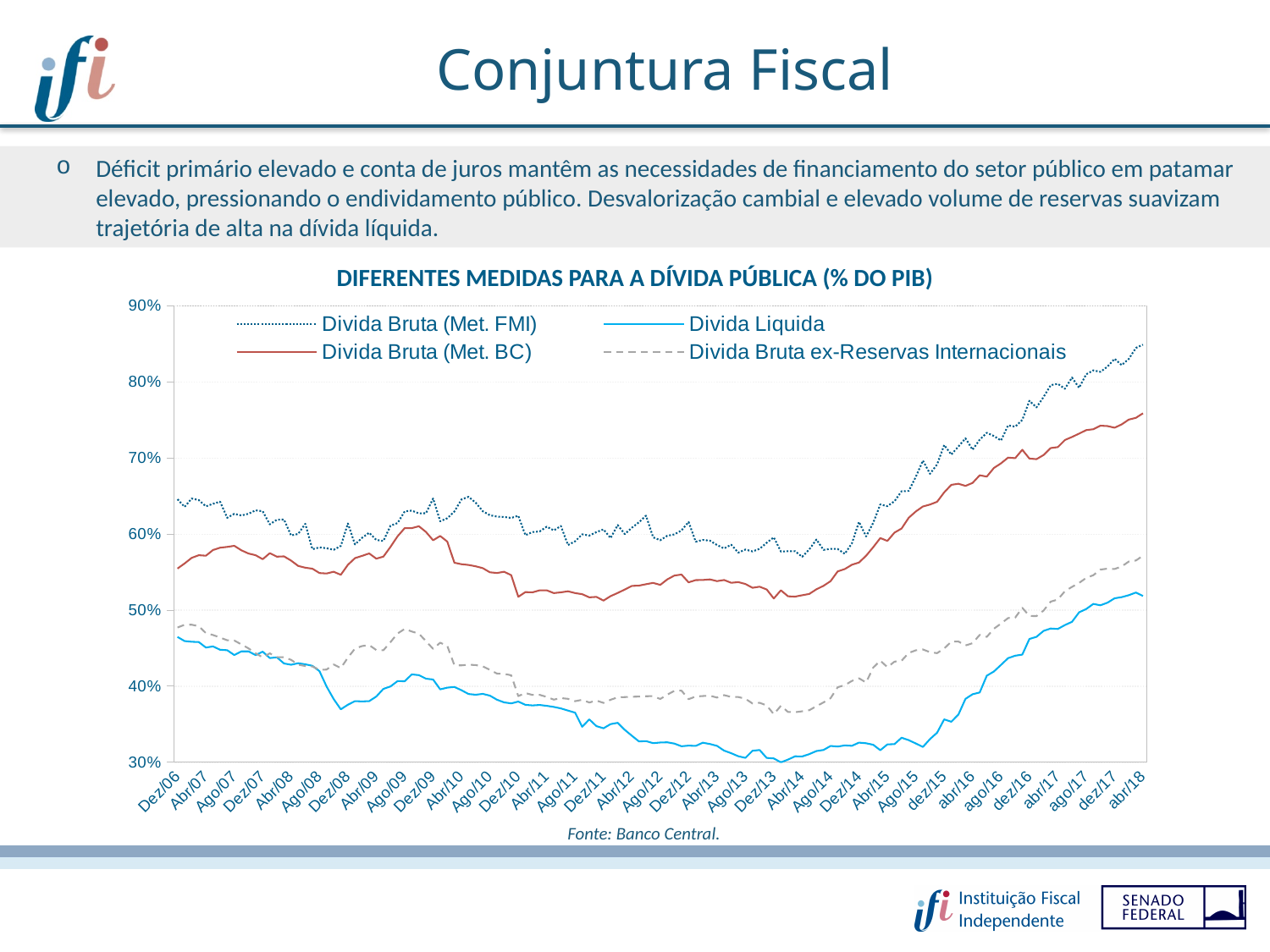
Is the value of Divida Liquida at Dez/13 greater or less than 40%? less Is the value of Divida Bruta (Met. BC) at abr/18 greater or less than 70%? greater Which series has the lowest value at abr/18? Divida Liquida How many series does the chart legend list? 4 What kind of chart is shown on the slide? line chart Which series has the highest value at abr/18? Divida Bruta (Met. FMI) Is the value of Divida Bruta (Met. BC) at Dez/06 greater or less than 60%? less What source is cited below the chart? Banco Central What is the title of the chart? DIFERENTES MEDIDAS PARA A DÍVIDA PÚBLICA (% DO PIB) Does Divida Liquida rise or fall between Dez/06 and Dez/13? fall